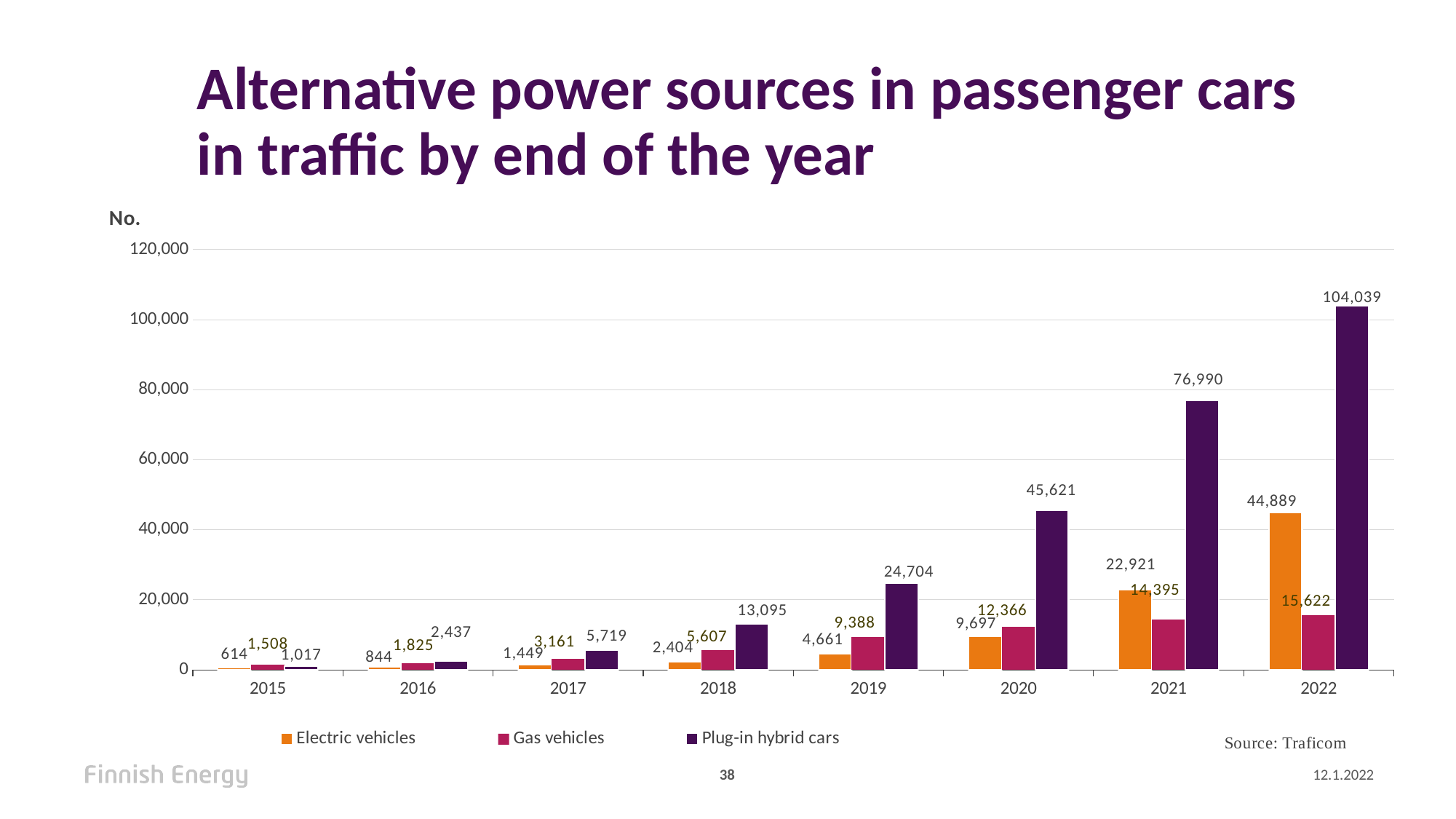
How many series does the legend list? 3 What is the difference between Plug-in hybrid cars in 2022 and in 2021? 27,049 How many years are shown on the x axis? 8 What is the value for Plug-in hybrid cars in 2018? 13,095 What is the value for Plug-in hybrid cars in 2022? 104,039 In which year is the value for Plug-in hybrid cars highest? 2022 Which is larger in 2021: Electric vehicles or Gas vehicles? Electric vehicles In which year is the value for Electric vehicles lowest? 2015 What kind of chart is shown on the slide? Bar chart What is the value for Gas vehicles in 2019? 9,388 What is the value for Electric vehicles in 2021? 22,921 Is the value for Plug-in hybrid cars in 2020 greater or less than 40,000? greater